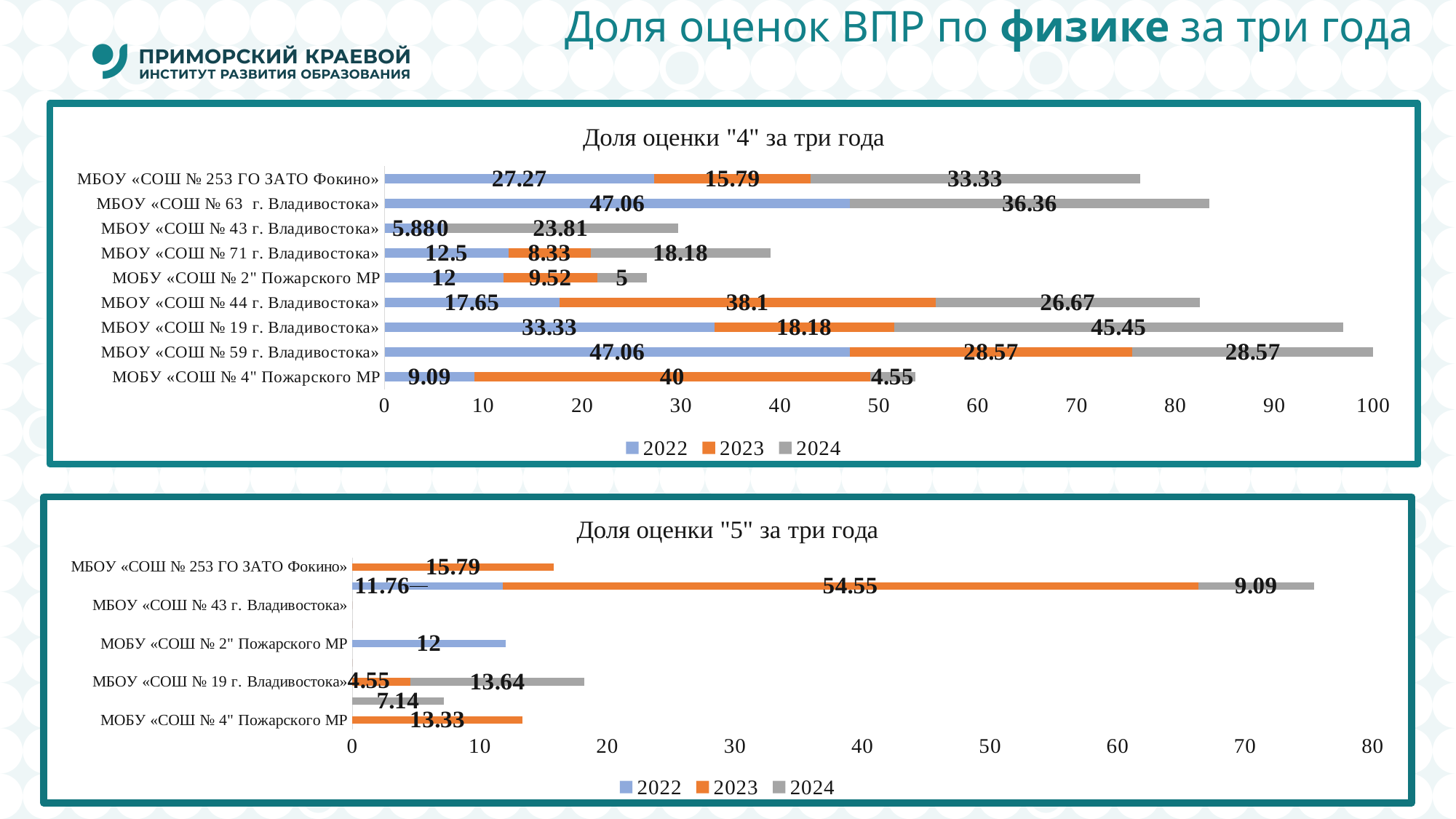
How many schools are shown in the "Доля оценки "4" за три года" chart? 9 In the "Доля оценки "4" за три года" chart, what is the 2023 value for МБОУ «СОШ № 44 г. Владивостока»? 38.1 How many series does the legend of the "Доля оценки "4" за три года" chart list? 3 In the "Доля оценки "5" за три года" chart, what is the 2022 value for МОБУ «СОШ № 2" Пожарского МР? 12 What kind of chart is the "Доля оценки "4" за три года" chart? bar chart In the "Доля оценки "4" за три года" chart, what is the 2024 value for МБОУ «СОШ № 19 г. Владивостока»? 45.45 In the "Доля оценки "4" за три года" chart, which school has the lowest 2022 value? МБОУ «СОШ № 43 г. Владивостока» In the "Доля оценки "4" за три года" chart, which is larger: the 2024 value for МБОУ «СОШ № 19 г. Владивостока» or for МБОУ «СОШ № 253 ГО ЗАТО Фокино»? МБОУ «СОШ № 19 г. Владивостока» In the "Доля оценки "4" за три года" chart, which school has the highest 2024 value? МБОУ «СОШ № 19 г. Владивостока» In the "Доля оценки "4" за три года" chart, what is the difference between the 2022 values for МБОУ «СОШ № 63 г. Владивостока» and МБОУ «СОШ № 253 ГО ЗАТО Фокино»? 19.79 In the "Доля оценки "4" за три года" chart, what is the total of the stacked bar for МОБУ «СОШ № 2" Пожарского МР? 26.52 In the "Доля оценки "5" за три года" chart, is the total stacked bar for МБОУ «СОШ № 19 г. Владивостока» greater or less than 20? less